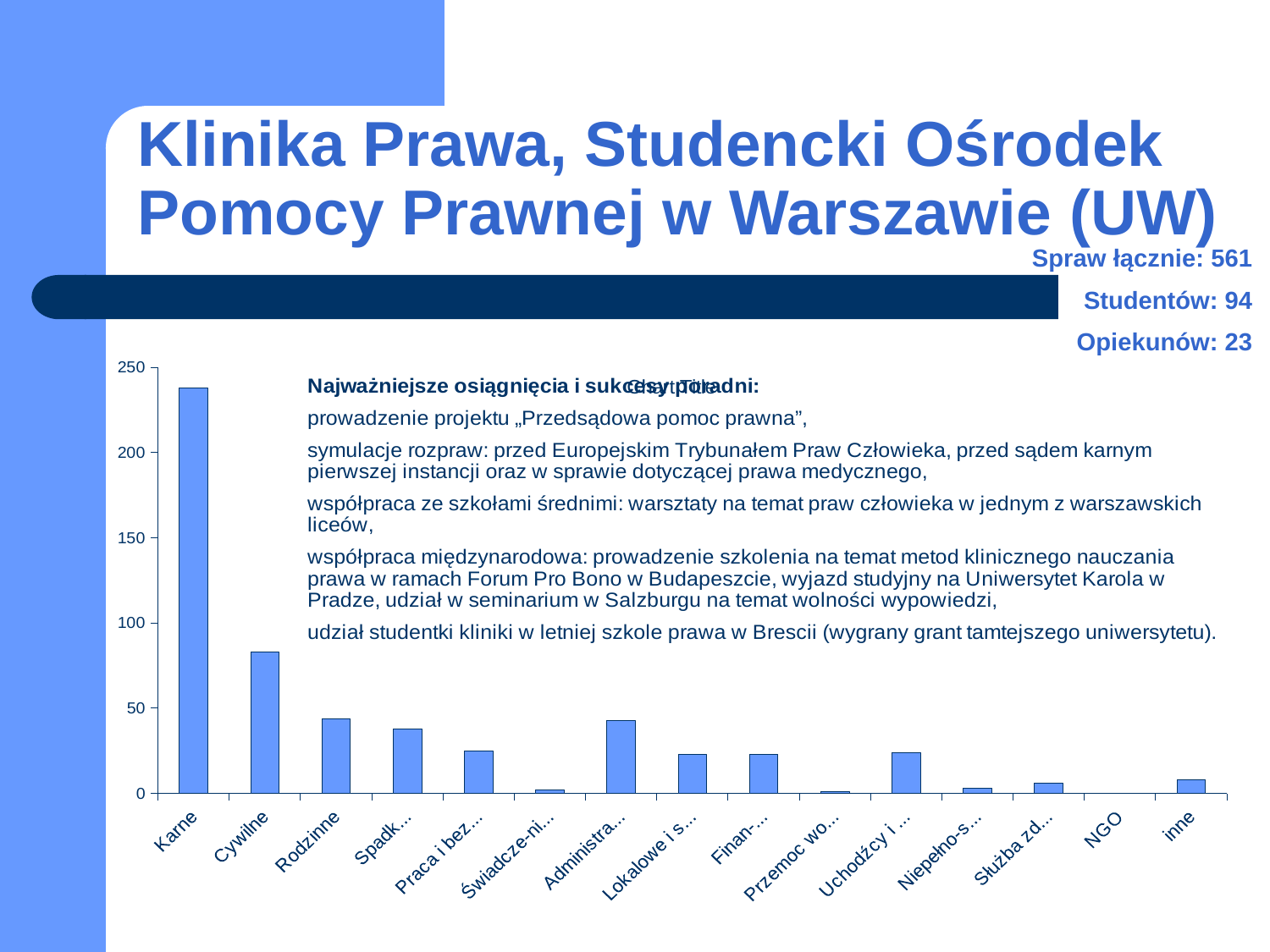
What kind of chart is shown on the slide? bar chart Is the value for Cywilne greater or less than 50? greater What is the first category label on the x axis of the chart? Karne Is the value for Rodzinne greater or less than 50? less Which category has the highest value in the chart? Karne Which has a larger value, Rodzinne or Praca i bez...? Rodzinne What is the last category label on the x axis of the chart? inne How many categories are shown on the x axis of the chart? 15 Which has a larger value, Karne or Cywilne? Karne Is the value for Karne greater or less than 200? greater Which has a larger value, Cywilne or Rodzinne? Cywilne